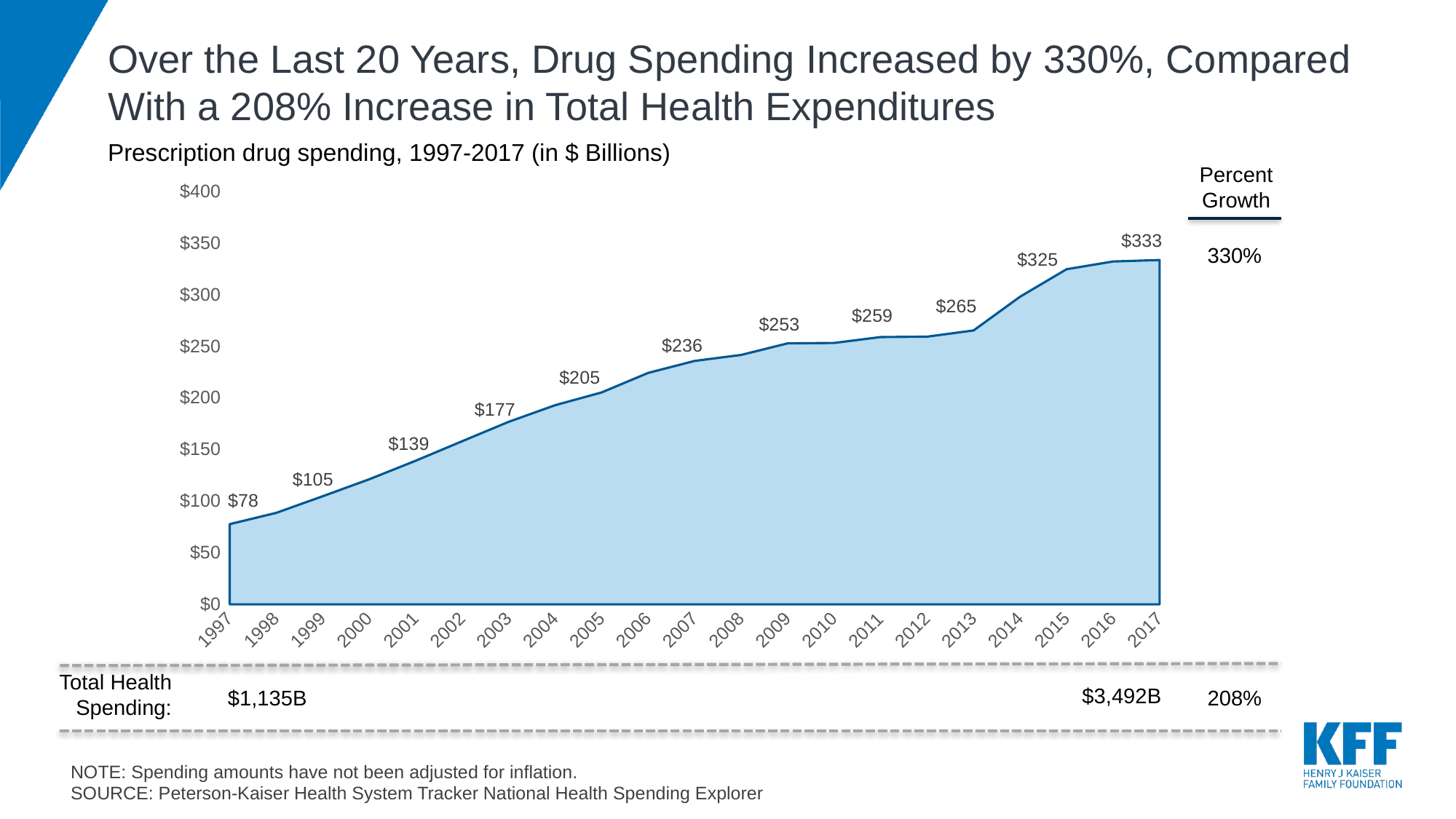
Is the value for 2000 greater or less than $100? greater What value is labeled for 2013? $265 Which year has the highest prescription drug spending? 2017 How many years are shown on the x axis? 21 What was prescription drug spending in 1997? $78 By how much did prescription drug spending increase from 1997 to 2017, in $ billions? $255 What kind of chart is shown on the slide? Area chart Which year has the lowest prescription drug spending? 1997 What was prescription drug spending in 2017? $333 Do the values rise or fall from 1997 to 2017? Rise Which year had higher prescription drug spending, 2003 or 2009? 2009 What value is labeled for 2007? $236